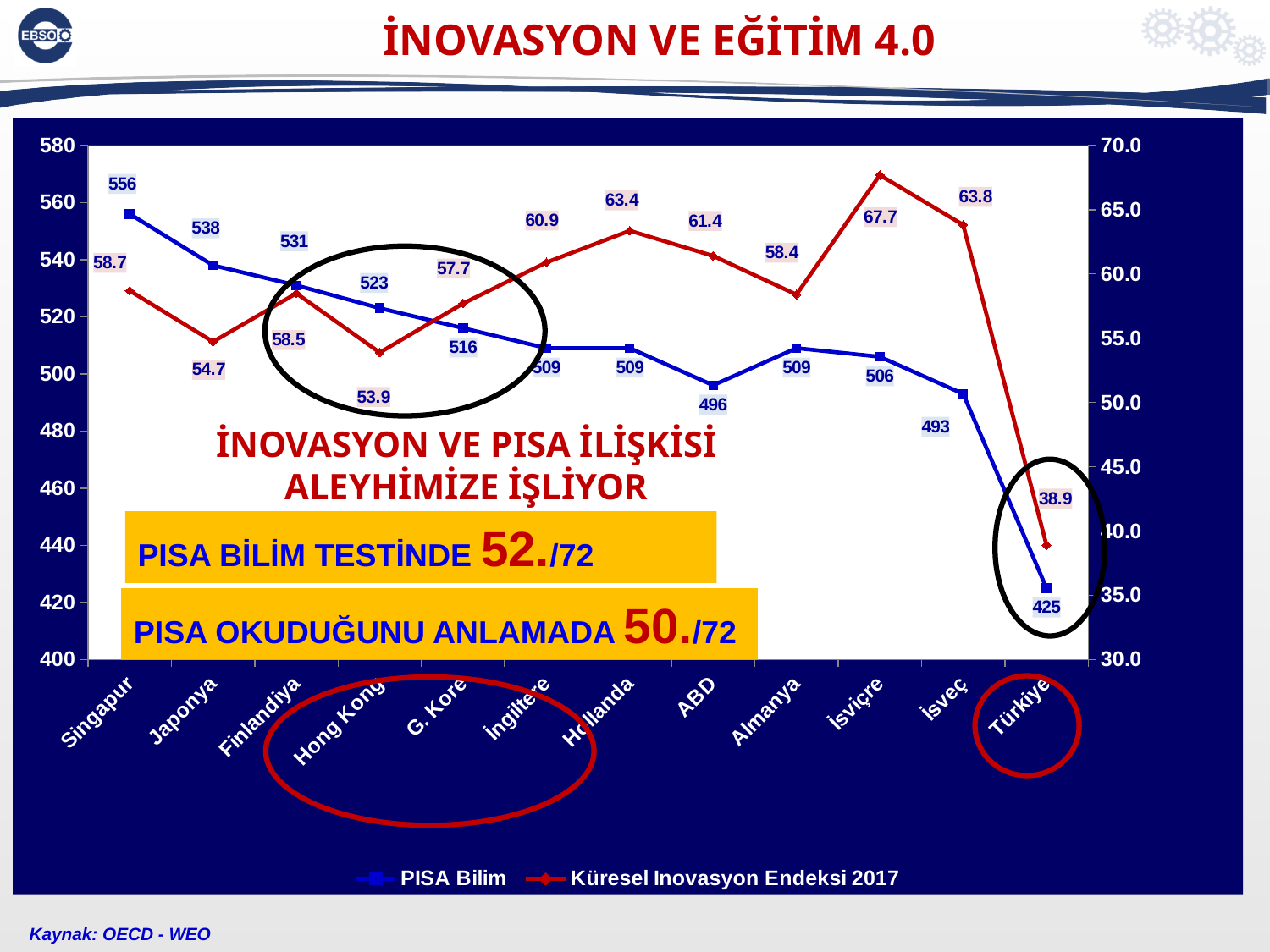
Which has a higher Küresel Inovasyon Endeksi 2017 value, Hollanda or ABD? Hollanda What is the PISA Bilim value for Singapur? 556 What is the PISA Bilim value for Türkiye? 425 How many countries are shown on the x axis? 12 What is the Küresel Inovasyon Endeksi 2017 value for Hong Kong? 53.9 Which country has the lowest Küresel Inovasyon Endeksi 2017 value? Türkiye What is the difference between the PISA Bilim values of Singapur and Türkiye? 131 How many series does the legend list? 2 Which country has the highest PISA Bilim value? Singapur Which series is drawn in red? Küresel Inovasyon Endeksi 2017 What kind of chart is shown on the slide? Line chart What is the Küresel Inovasyon Endeksi 2017 value for İsviçre? 67.7